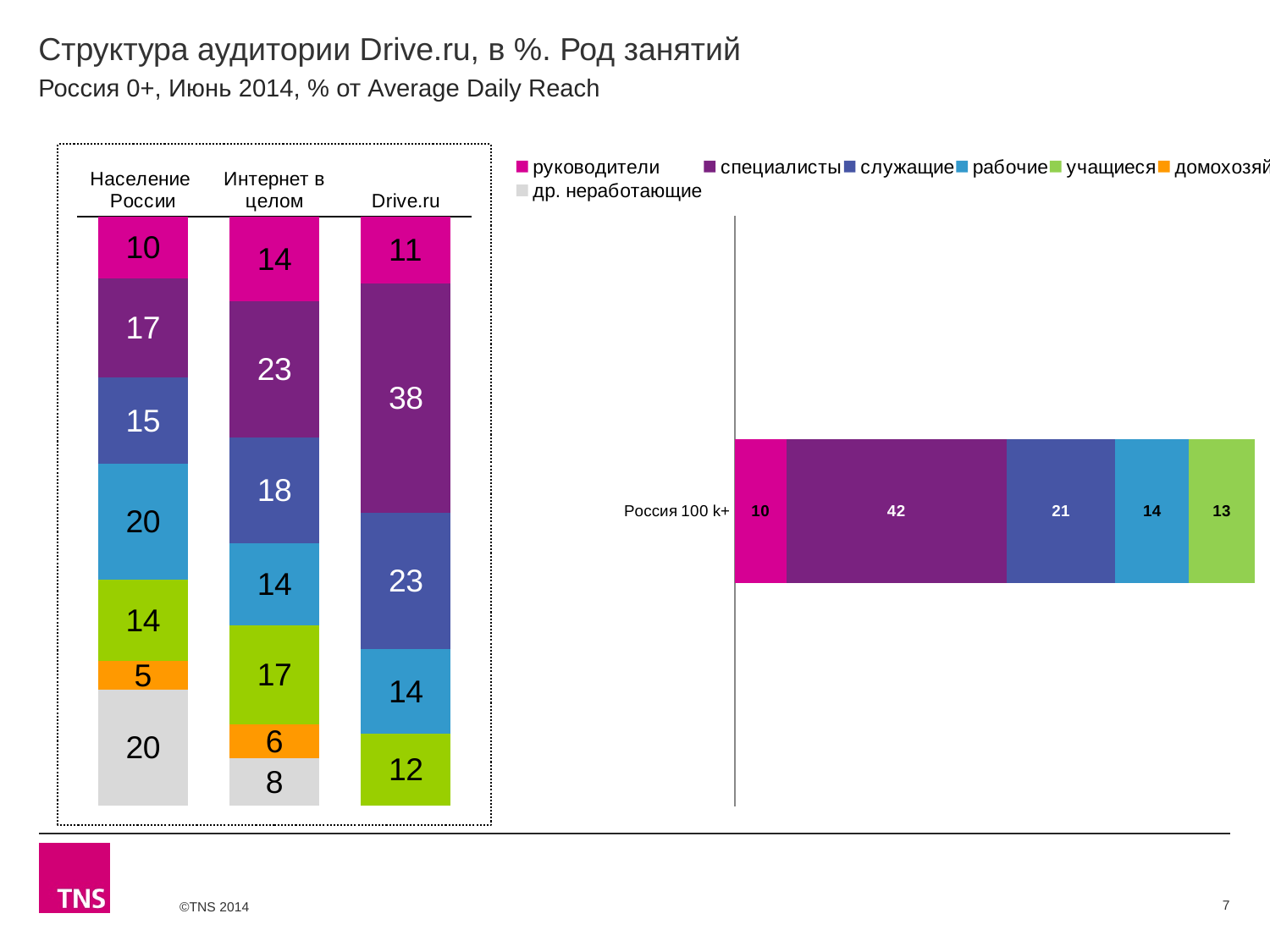
In the right chart, which segment of the Россия 100 k+ bar is the largest? специалисты In the left stacked bar chart, which is larger: the учащиеся value for Интернет в целом or for Drive.ru? Интернет в целом In the right chart, what is the value of the специалисты (purple) segment for Россия 100 k+? 42 How many bars (categories) are shown in the left stacked bar chart? 3 How many series does the legend on the right list? 7 In the left stacked bar chart, what is the value of the служащие (blue) segment for Интернет в целом? 18 In the left stacked bar chart, what is the value of the специалисты (purple) segment for Drive.ru? 38 In the left stacked bar chart, what is the difference between the специалисты values for Drive.ru and Население России? 21 In the right chart, what is the total of the Россия 100 k+ stacked bar? 100 What type of chart is shown on the right side of the slide? Stacked bar chart In the left stacked bar chart, what is the value of the рабочие (light blue) segment for Население России? 20 In the left stacked bar chart, which segment of the Drive.ru bar is the smallest? руководители